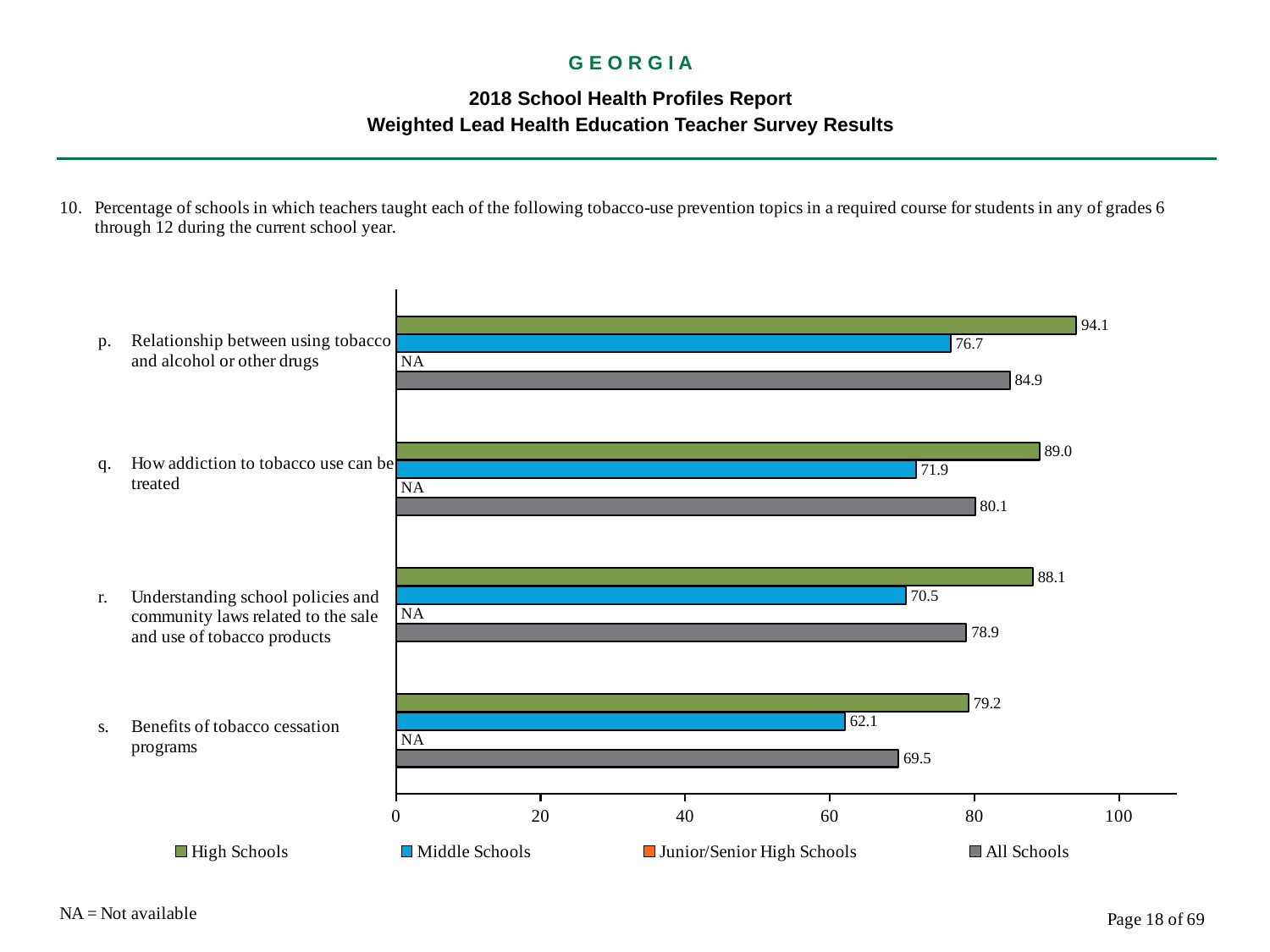
Is the Middle Schools value for "Understanding school policies and community laws related to the sale and use of tobacco products" greater or less than 80? less How many topics (categories) are shown in the chart? 4 How many series does the legend list? 4 Which is larger for "Benefits of tobacco cessation programs": the High Schools value or the All Schools value? High Schools What kind of chart is shown on the slide? bar chart Which topic has the lowest All Schools value? Benefits of tobacco cessation programs What is the Middle Schools value for "Benefits of tobacco cessation programs"? 62.1 What is the High Schools value for "Relationship between using tobacco and alcohol or other drugs"? 94.1 What is the Junior/Senior High Schools value for "Understanding school policies and community laws related to the sale and use of tobacco products"? NA What is the All Schools value for "How addiction to tobacco use can be treated"? 80.1 Which topic has the highest High Schools value? Relationship between using tobacco and alcohol or other drugs What is the difference between the High Schools and Middle Schools values for "How addiction to tobacco use can be treated"? 17.1